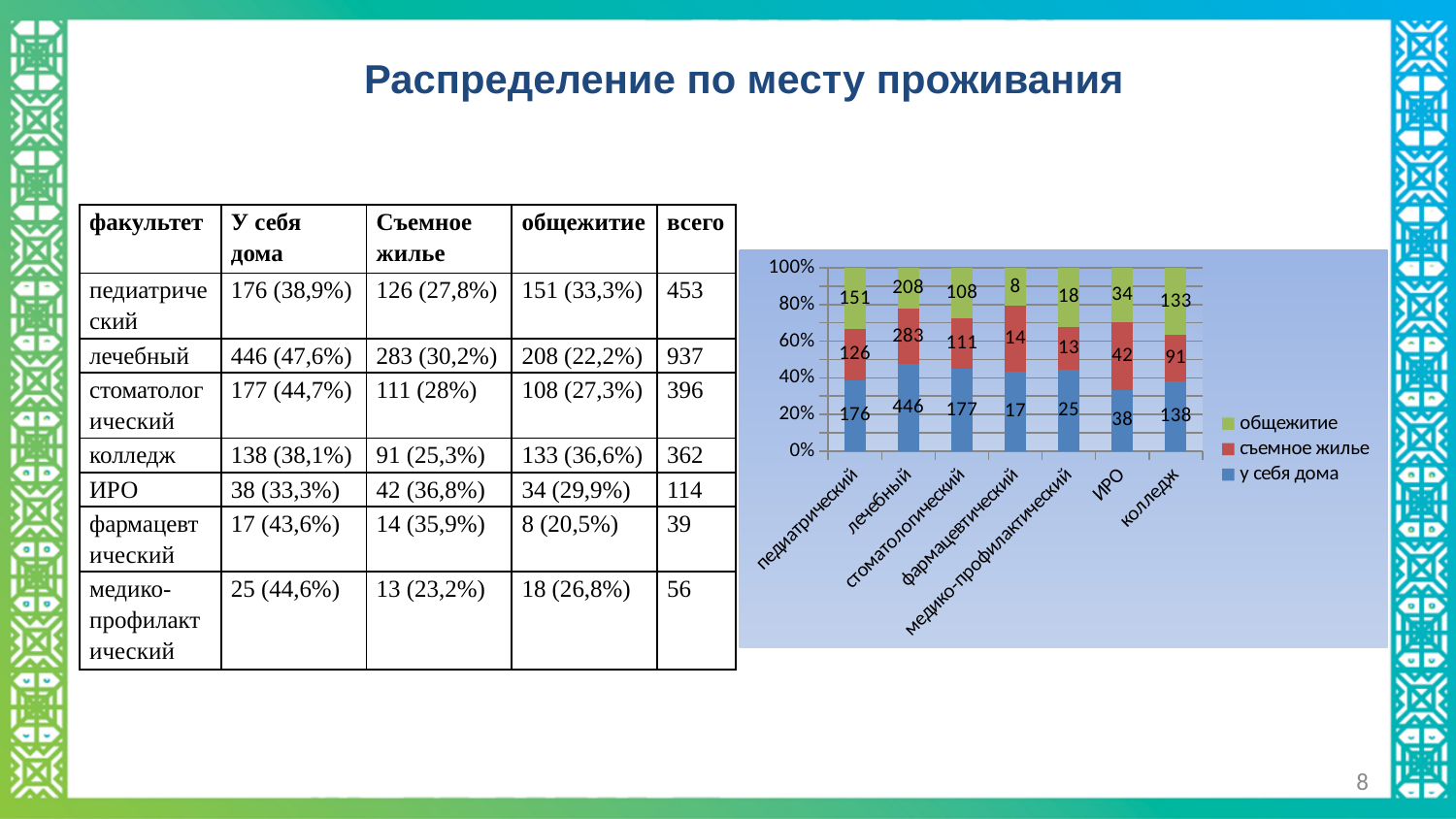
How many series does the chart legend list? 3 How many faculties (categories) are shown on the x axis of the chart? 7 Which is larger for ИРО: 'съемное жилье' or 'у себя дома'? съемное жилье Which faculty has the lowest value for 'общежитие' in the chart? фармацевтический What is the value of 'съемное жилье' for ИРО in the chart? 42 What is the difference between the 'съемное жилье' values for лечебный and педиатрический? 157 What is the total of the three values in the bar for стоматологический? 396 Which faculty has the highest value for 'у себя дома' in the chart? лечебный What is the value of 'у себя дома' for лечебный in the chart? 446 What kind of chart is shown on the slide? stacked bar chart What is the value of 'общежитие' for фармацевтический in the chart? 8 What is the value of 'общежитие' for колледж in the chart? 133